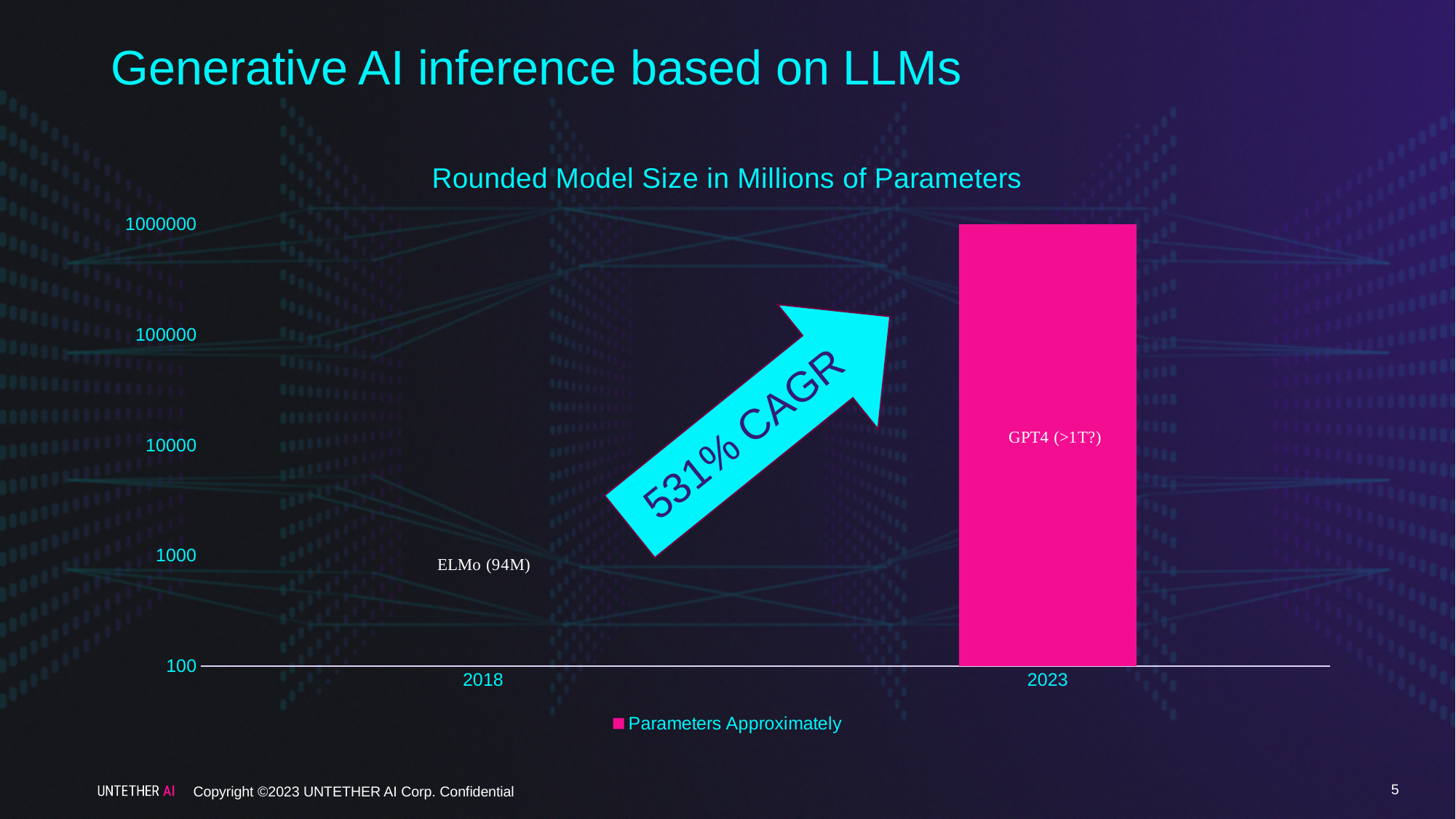
How many series does the chart's legend list? 1 Do the values rise or fall from 2018 to 2023? rise Which is larger, the value for 2018 or the value for 2023? 2023 What percentage CAGR is written on the arrow in the chart? 531% CAGR What kind of chart is shown on the slide? bar chart Is the value for 2023 greater or less than 100000? greater What label is printed for the 2018 category? ELMo (94M) What label is printed on the bar for 2023? GPT4 (>1T?) What is the name of the series listed in the chart's legend? Parameters Approximately Which year has the highest value in the chart? 2023 Which year has the lowest value in the chart? 2018 How many categories are shown on the x axis of the chart? 2